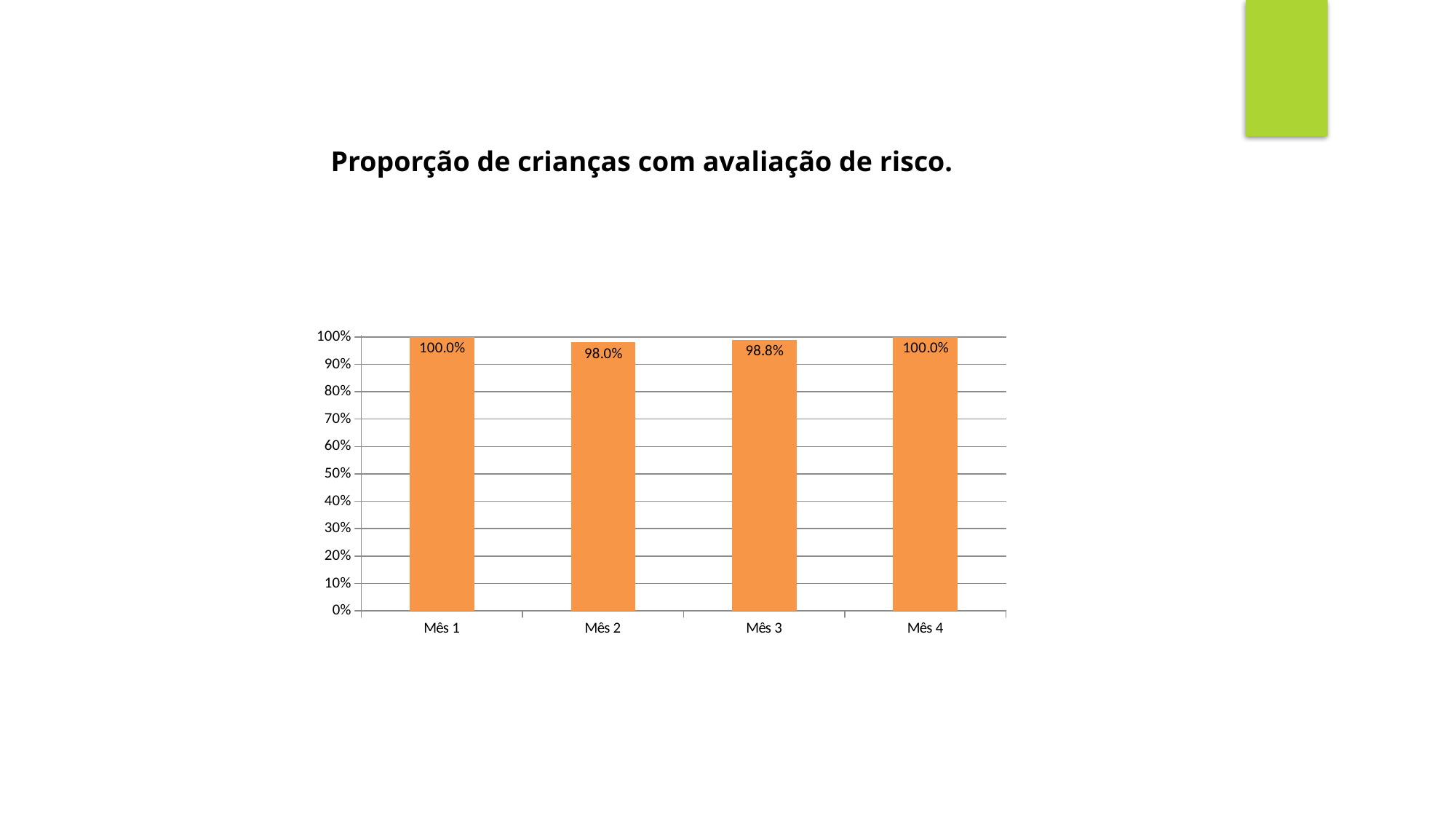
What is the value for Mês 2? 98.0% What is the difference between the values for Mês 3 and Mês 2? 0.8% Which is larger, the value for Mês 2 or the value for Mês 3? Mês 3 What kind of chart is shown on the slide? bar chart Which month has the lowest value? Mês 2 What is the difference between the values for Mês 1 and Mês 2? 2.0% What is the value for Mês 3? 98.8% How many months are shown on the x axis? 4 What is the title of the chart? Proporção de crianças com avaliação de risco. What is the value for Mês 4? 100.0% What is the value for Mês 1? 100.0% Is the value for Mês 2 greater or less than 90%? greater